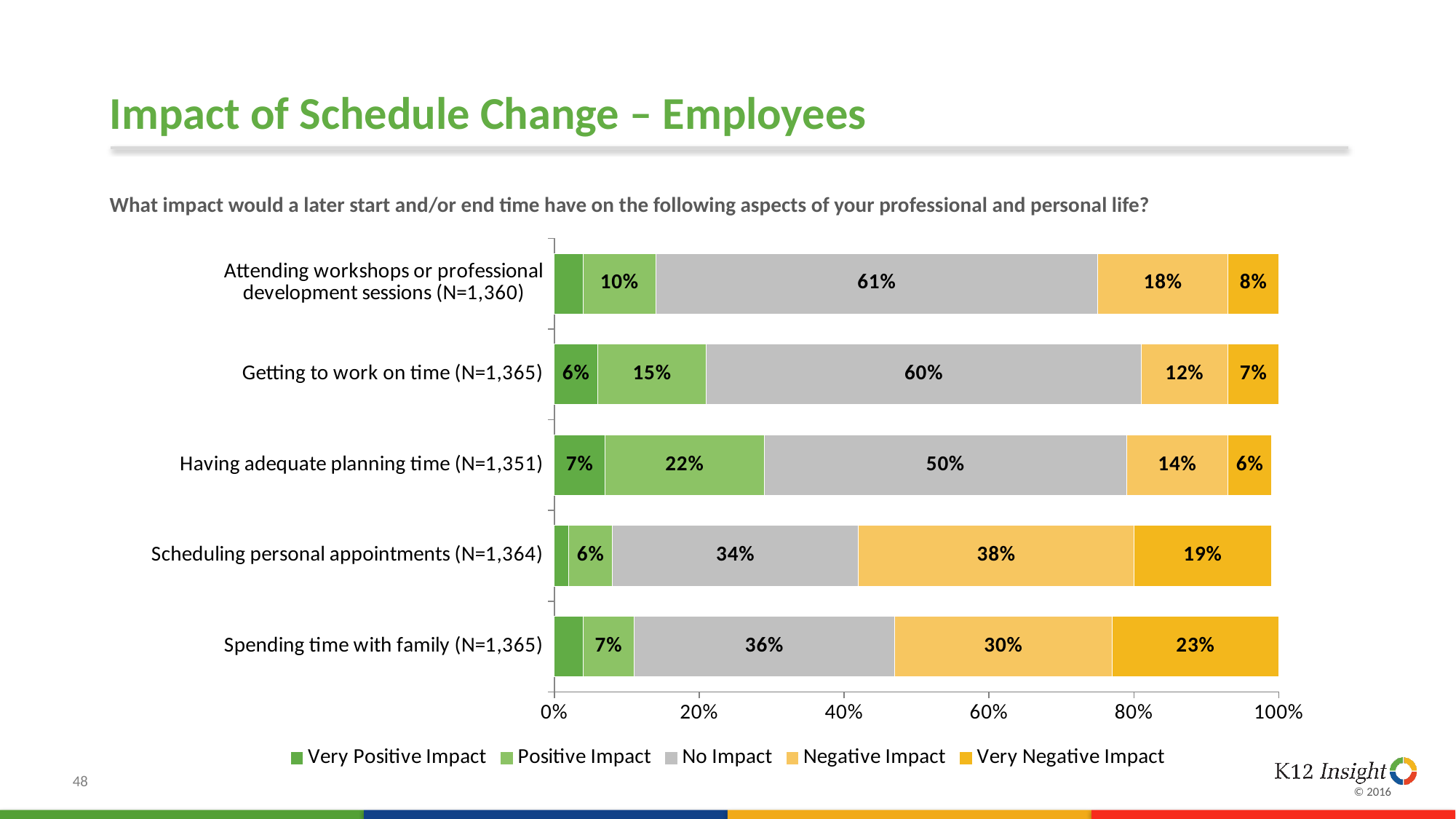
What is the Positive Impact value for Having adequate planning time? 22% What percentage of employees said a later start and/or end time would have No Impact on attending workshops or professional development sessions? 61% How many series does the legend list? 5 How many categories (aspects of life) are shown in the chart? 5 What is the Negative Impact value for Scheduling personal appointments? 38% What kind of chart is shown on the slide? Stacked bar chart What is the Very Negative Impact value for Spending time with family? 23% Which category has the highest Very Negative Impact percentage? Spending time with family Which category has the lowest No Impact percentage? Scheduling personal appointments Which is larger: the Negative Impact value for Scheduling personal appointments or for Spending time with family? Scheduling personal appointments What is the difference between the No Impact values for Getting to work on time and Having adequate planning time? 10% What is the sample size (N) shown for Having adequate planning time? 1,351